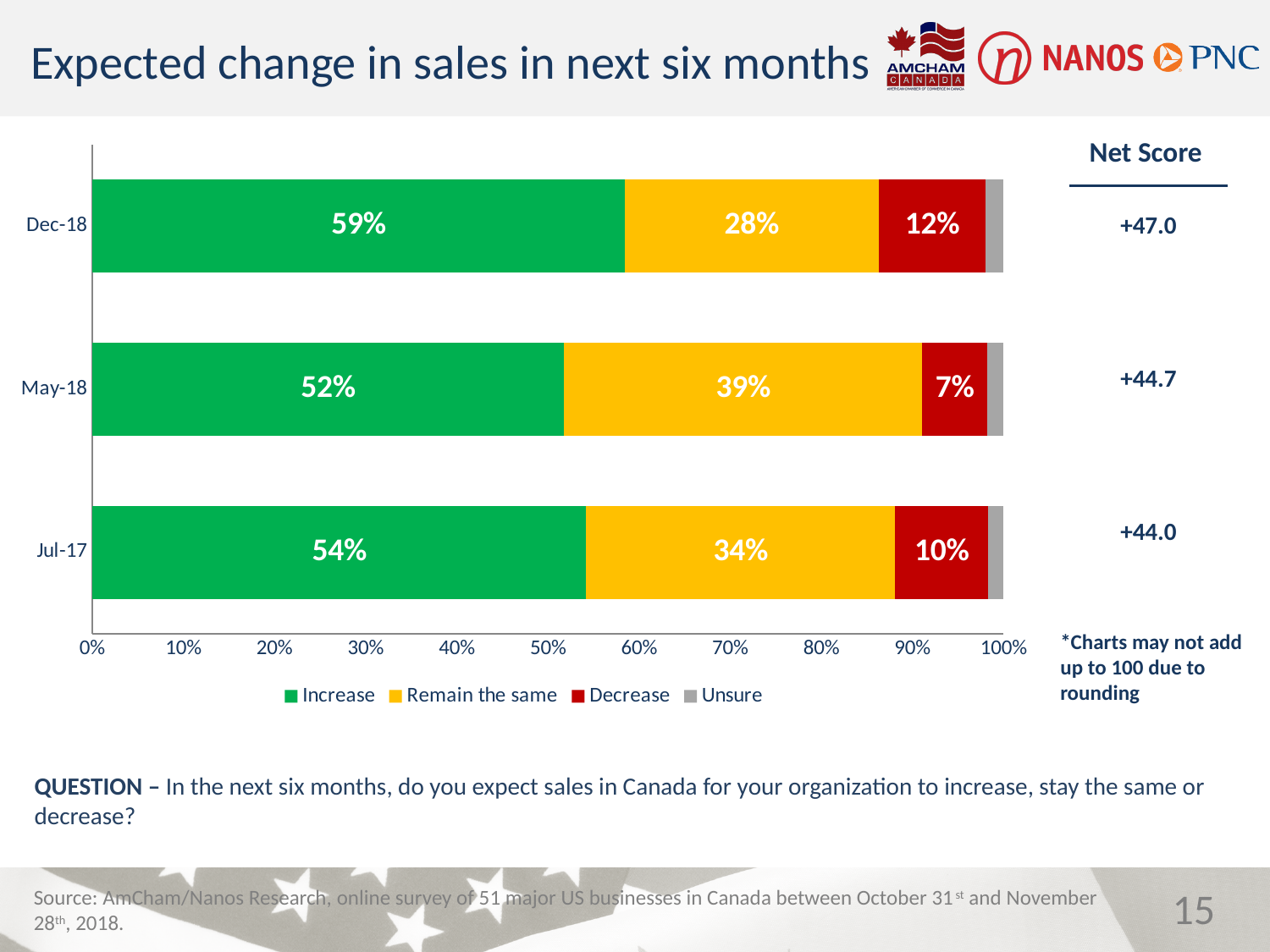
What percentage expected sales to decrease in Jul-17? 10% Which survey period has the highest 'Increase' value? Dec-18 How many series does the legend list? 4 Is the 'Increase' value for Dec-18 greater or less than 50%? greater What is the difference between the 'Remain the same' values for May-18 and Dec-18? 11% Which survey period has the lowest 'Decrease' value? May-18 What is the Net Score shown for May-18? +44.7 What kind of chart is shown on the slide? Stacked bar chart What is the 'Remain the same' value for May-18? 39% What percentage of respondents expected sales to increase in Dec-18? 59% How many survey periods are shown on the chart? 3 Which is larger: the 'Increase' value for May-18 or for Jul-17? Jul-17